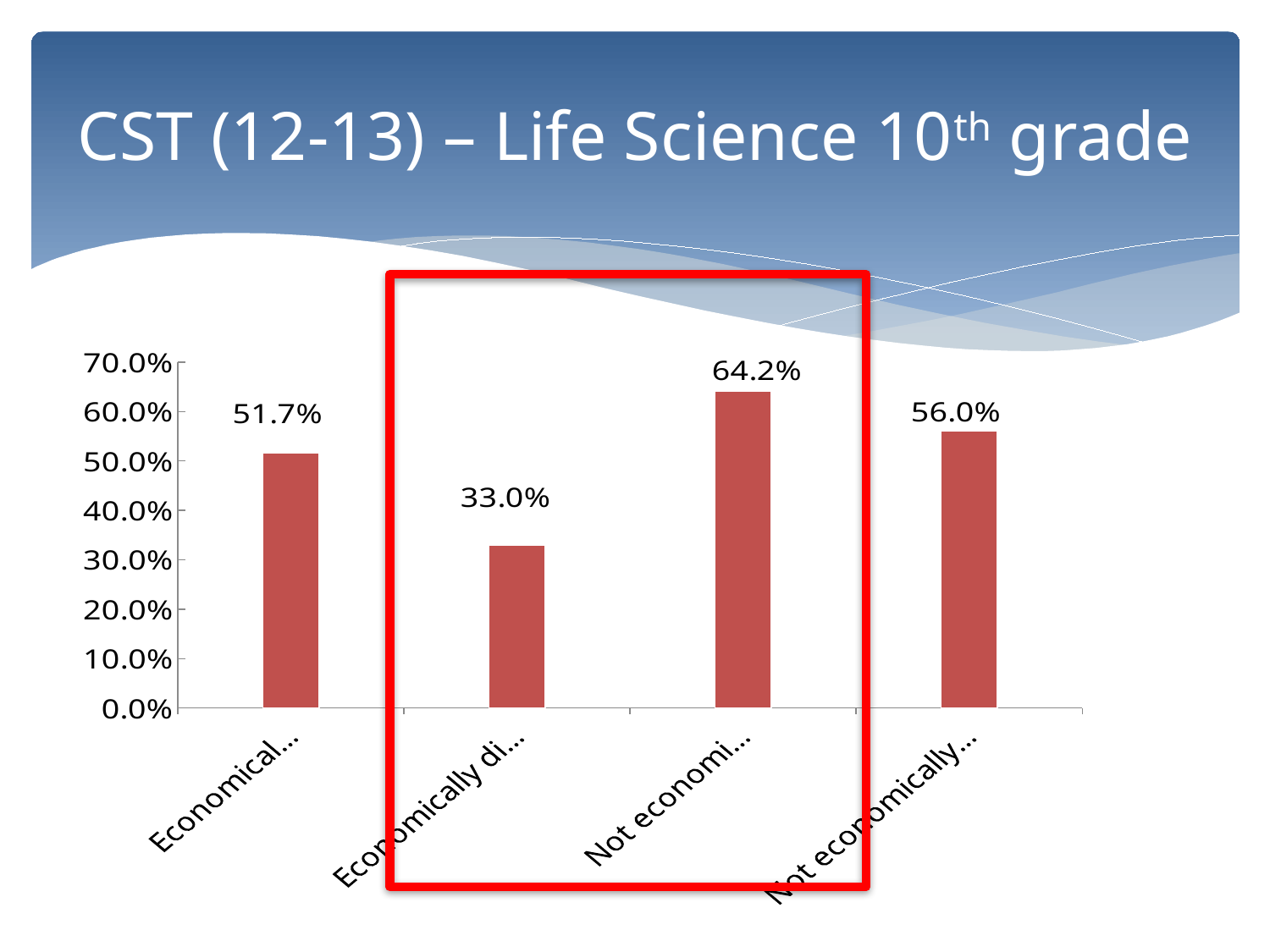
Which is larger, the first bar or the fourth bar? The fourth bar (56.0%) What is the value of the third bar from the left? 64.2% Which bar has the lowest value? The second bar from the left (33.0%) What is the value of the second bar from the left? 33.0% What is the difference between the highest and lowest bar values? 31.2% What is the title of the slide? CST (12-13) – Life Science 10th grade What type of chart is shown on the slide? Bar chart What is the value of the fourth bar from the left? 56.0% What is the difference between the fourth bar (56.0%) and the first bar (51.7%)? 4.3% What is the value of the first bar from the left? 51.7% How many bars are plotted in the chart? 4 Which bar has the highest value? The third bar from the left (64.2%)